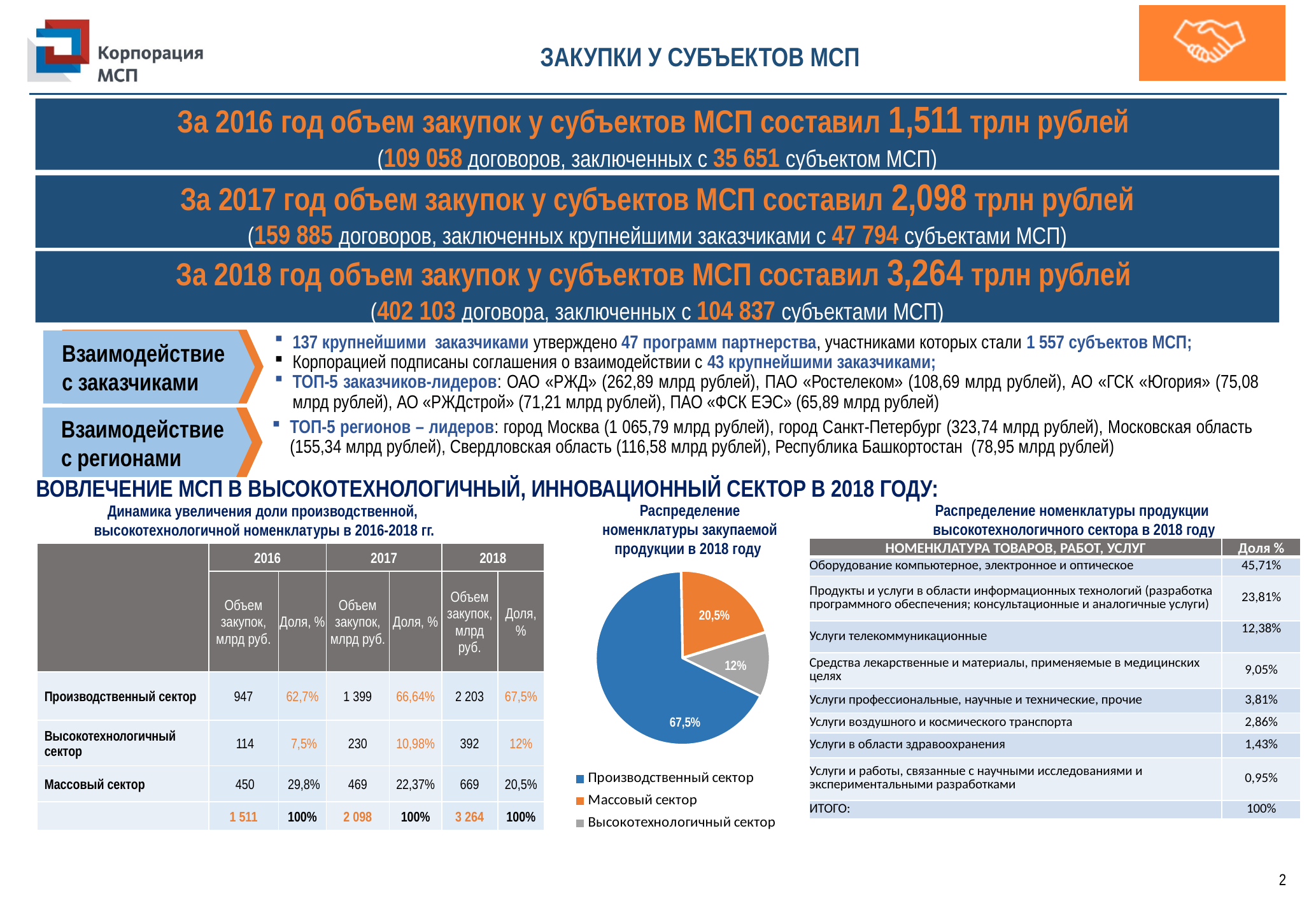
Which slice of the pie chart is the smallest? Высокотехнологичный сектор What kind of chart is shown under the title "Распределение номенклатуры закупаемой продукции в 2018 году"? pie chart What colour is the "Массовый сектор" slice in the pie chart? orange In the pie chart, which is larger: "Массовый сектор" or "Высокотехнологичный сектор"? Массовый сектор Which slice of the pie chart is the largest? Производственный сектор In the pie chart, what share does "Высокотехнологичный сектор" have? 12% In the pie chart, what is the difference in percentage points between "Производственный сектор" and "Массовый сектор"? 47 percentage points How many slices does the pie chart have? 3 How many entries does the legend of the pie chart list? 3 In the pie chart, what share does "Производственный сектор" have? 67,5% In the pie chart, what share does "Массовый сектор" have? 20,5% In the pie chart, what is the difference in percentage points between "Массовый сектор" and "Высокотехнологичный сектор"? 8,5 percentage points